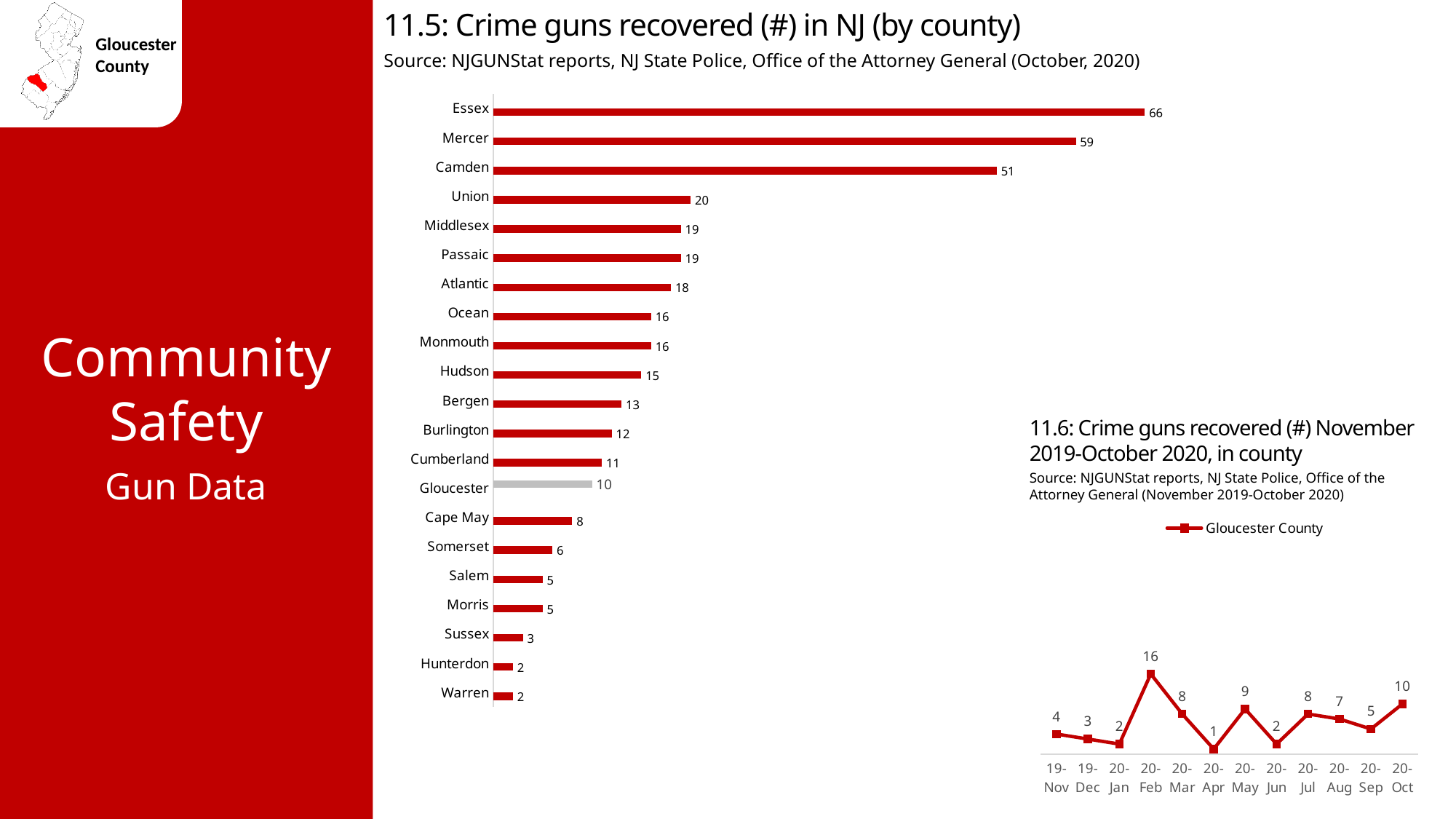
In the chart '11.5: Crime guns recovered (#) in NJ (by county)', which county's bar is coloured grey instead of red? Gloucester How many series does the legend of chart '11.6: Crime guns recovered (#) November 2019-October 2020, in county' list? 1 What kind of chart is '11.5: Crime guns recovered (#) in NJ (by county)'? Bar chart In the chart '11.5: Crime guns recovered (#) in NJ (by county)', which has more crime guns recovered, Union or Hudson? Union In the chart '11.6: Crime guns recovered (#) November 2019-October 2020, in county', what is the value for 20-Feb? 16 In the chart '11.6: Crime guns recovered (#) November 2019-October 2020, in county', what is the difference between 20-Oct and 20-Sep? 5 In the chart '11.6: Crime guns recovered (#) November 2019-October 2020, in county', which month has the lowest value? 20-Apr In the chart '11.5: Crime guns recovered (#) in NJ (by county)', what is the value for Camden? 51 In the chart '11.5: Crime guns recovered (#) in NJ (by county)', which county has the highest number of crime guns recovered? Essex In the chart '11.5: Crime guns recovered (#) in NJ (by county)', how many crime guns were recovered in Gloucester? 10 In the chart '11.5: Crime guns recovered (#) in NJ (by county)', how many counties are shown? 21 In the chart '11.5: Crime guns recovered (#) in NJ (by county)', what is the difference between Essex and Mercer? 7